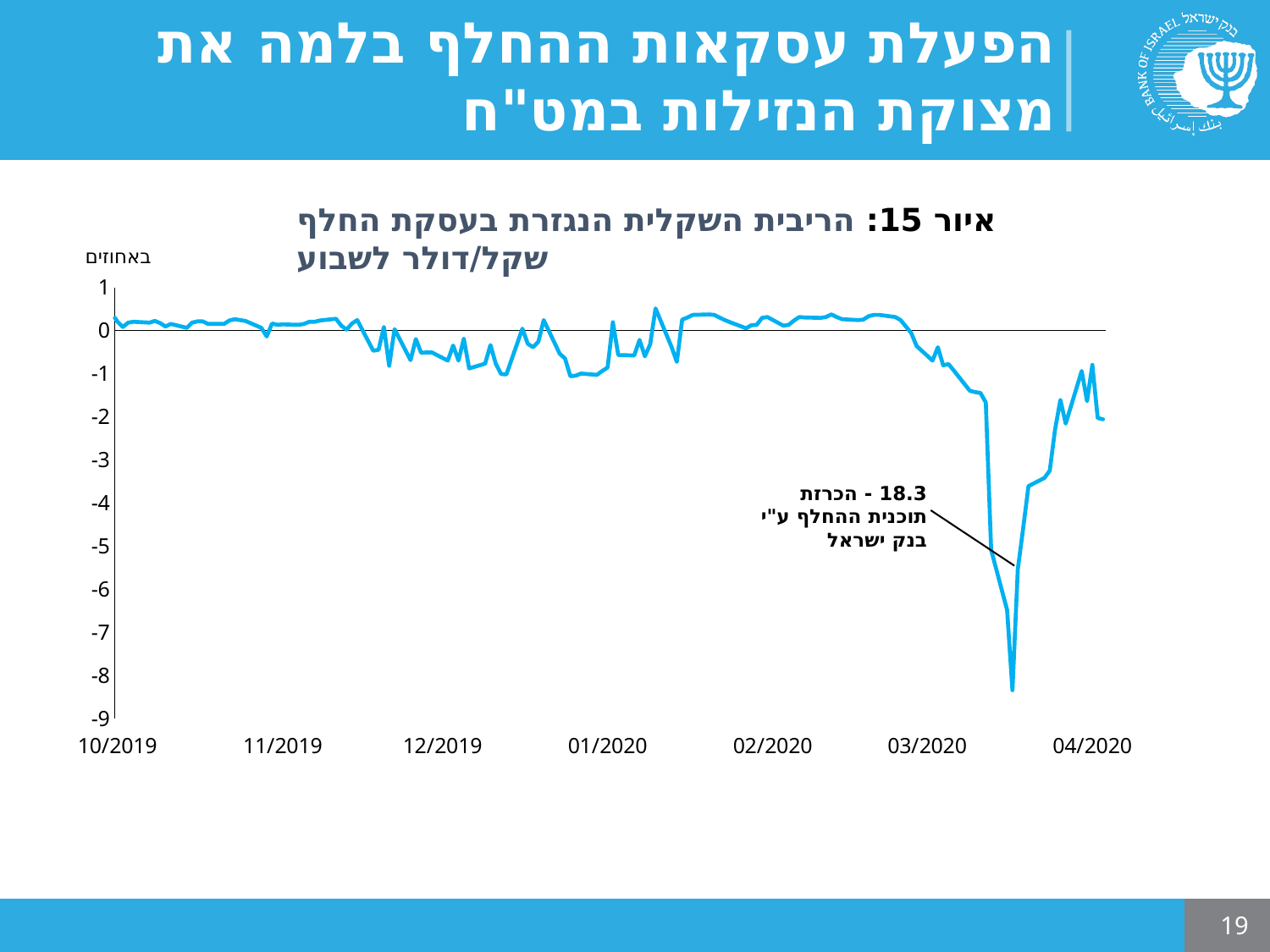
What date is given in the annotation marking the Bank of Israel swap program announcement? 18.3 What is the figure number given in the chart title? 15 In which month does the line reach its lowest point? March 2020 Is the value of the line at 02/2020 greater or less than -2? greater Is the value of the line at 10/2019 greater or less than -1? greater What is the lowest value shown on the y-axis? -9 Is the lowest point of the line greater or less than -7? less How many date labels are shown along the x-axis? 7 Between 03/2020 and the middle of March 2020, does the line rise or fall? fall What kind of chart is shown on the slide? line chart